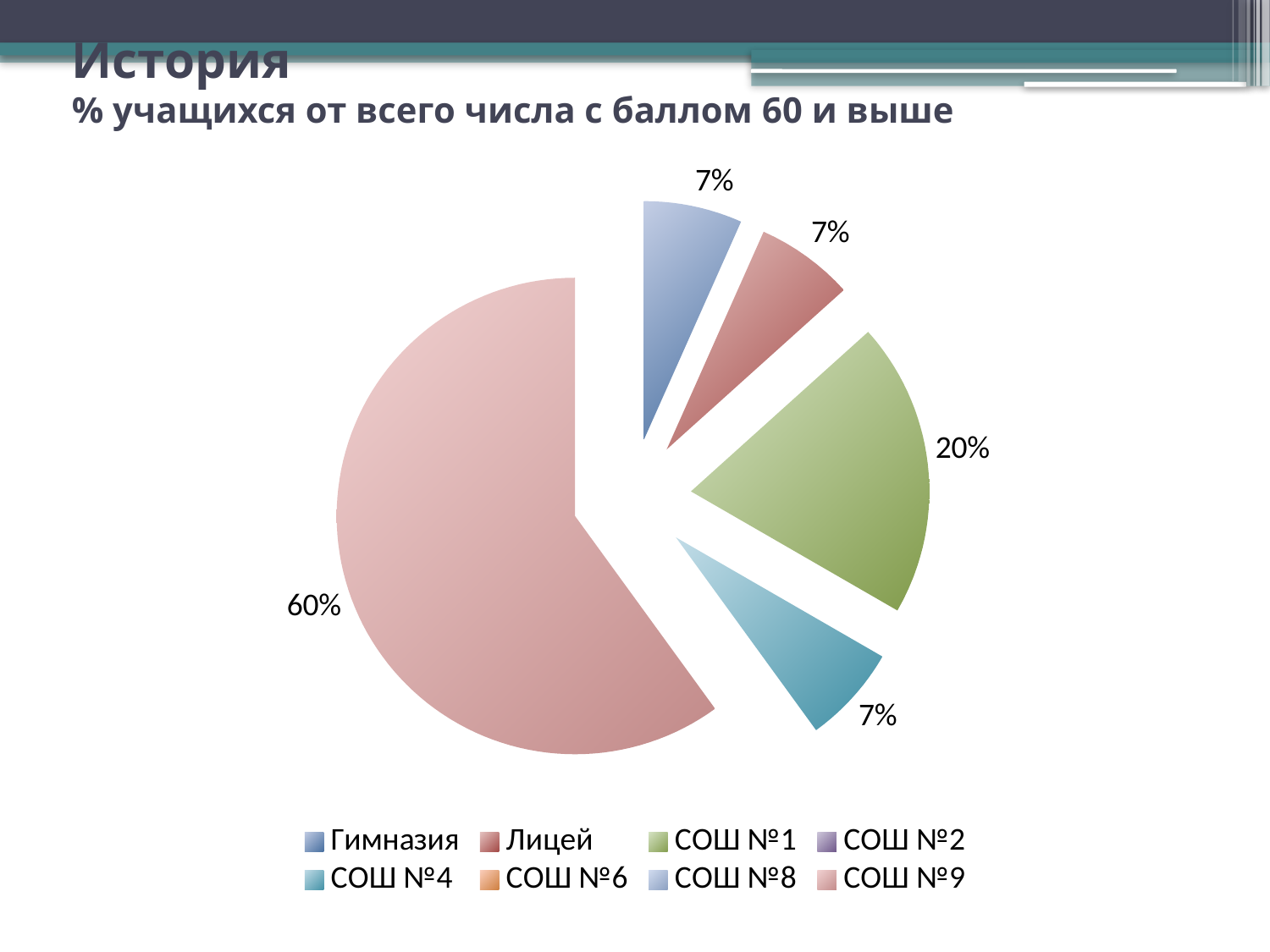
What is the difference between the values for СОШ №9 and СОШ №1? 40% Which category has the largest slice of the pie? СОШ №9 What kind of chart is shown on the slide? pie chart What is the value shown for Гимназия? 7% What is the subtitle of the chart below the word История? % учащихся от всего числа с баллом 60 и выше What is the difference between the values for СОШ №1 and Лицей? 13% What share of the pie does СОШ №9 have? 60% What is the value shown for СОШ №1? 20% How many categories does the legend list? 8 What is the value shown for СОШ №4? 7% Which is larger, the slice for СОШ №1 or the slice for Гимназия? СОШ №1 What is the value shown for Лицей? 7%